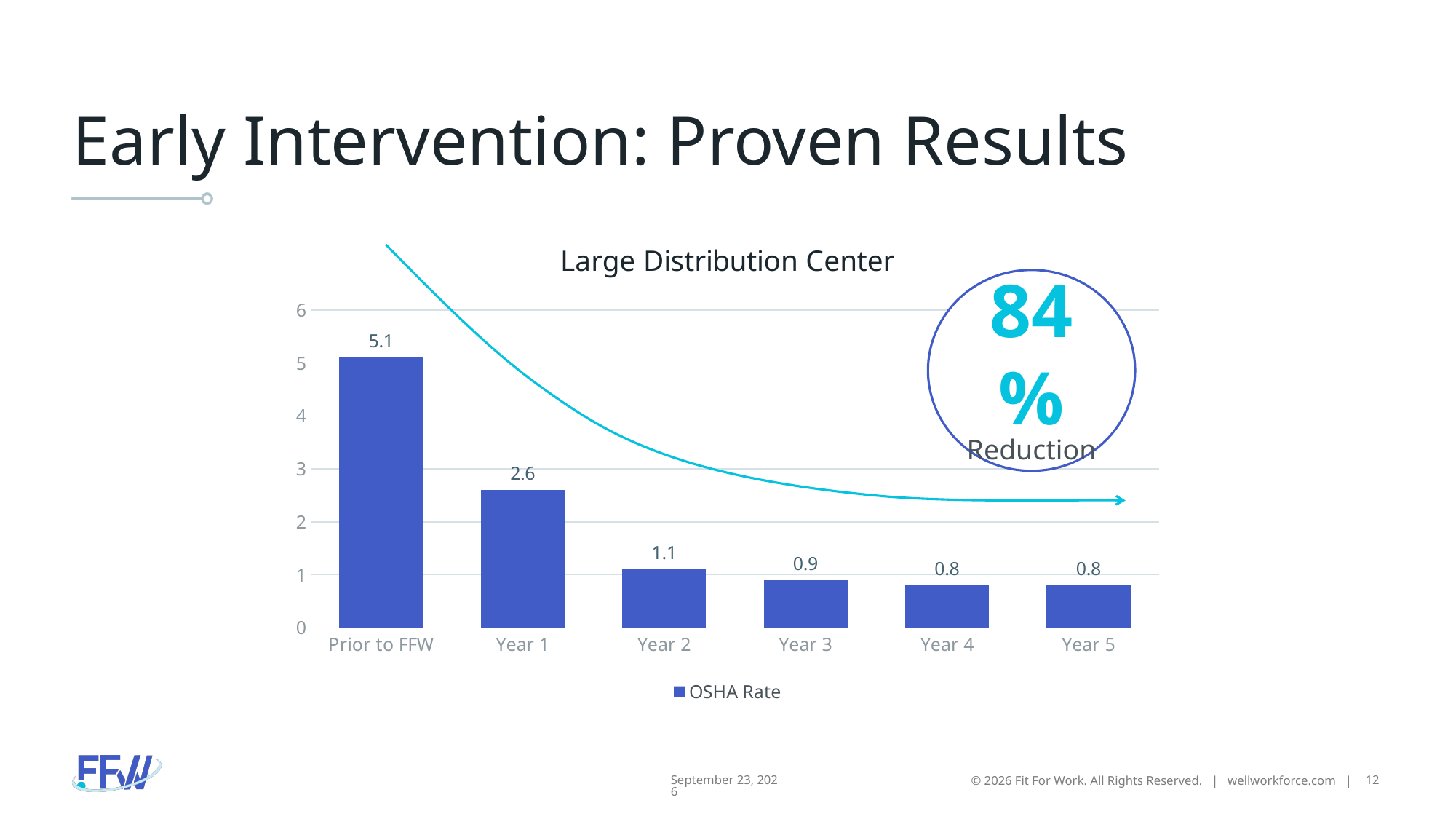
What is the OSHA Rate for Year 3? 0.9 What is the OSHA Rate for Prior to FFW? 5.1 What kind of chart is shown on the slide? bar chart How many categories are shown on the x axis? 6 What is the OSHA Rate for Year 1? 2.6 Which is larger, the OSHA Rate for Year 1 or Year 2? Year 1 Is the OSHA Rate for Year 1 greater or less than 3? less What is the difference between the OSHA Rate for Year 2 and Year 5? 0.3 Which category has the highest OSHA Rate? Prior to FFW What is the difference between the OSHA Rate for Prior to FFW and Year 1? 2.5 How many series does the legend list? 1 Do the OSHA Rate values rise or fall from Prior to FFW to Year 5? fall